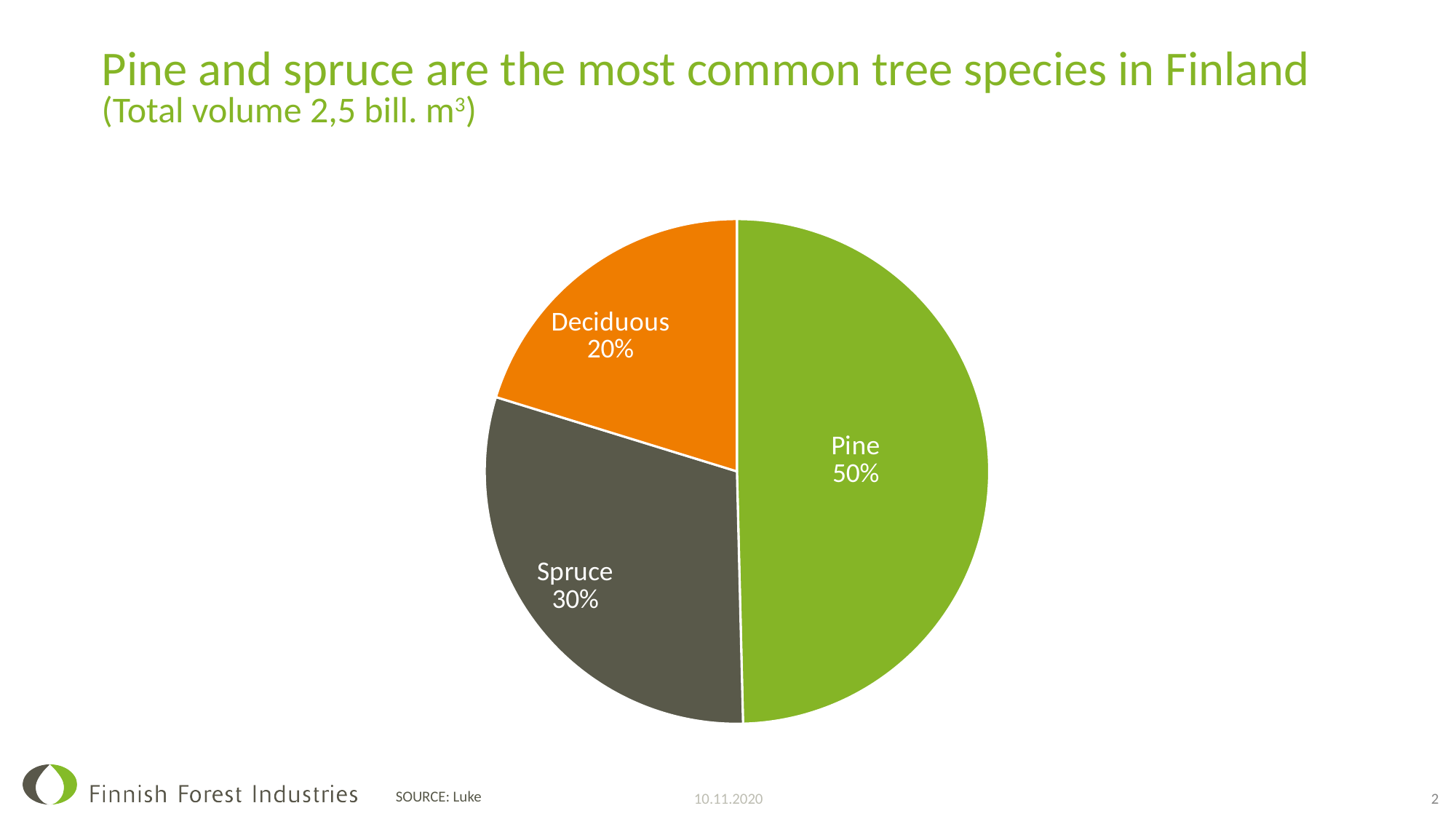
What is the difference in percentage points between the Pine and Spruce slices? 20 What kind of chart is shown on the slide? pie chart What share of the pie does Spruce account for? 30% What total volume is stated in the slide subtitle? 2,5 bill. m³ Which tree species has the largest slice of the pie? Pine What colour is the Deciduous slice? orange What share of the pie does Deciduous account for? 20% Which tree species has the smallest slice of the pie? Deciduous What is the difference in percentage points between the Spruce and Deciduous slices? 10 Which slice is larger, Spruce or Deciduous? Spruce What share of the pie does Pine account for? 50% How many slices does the pie chart have? 3